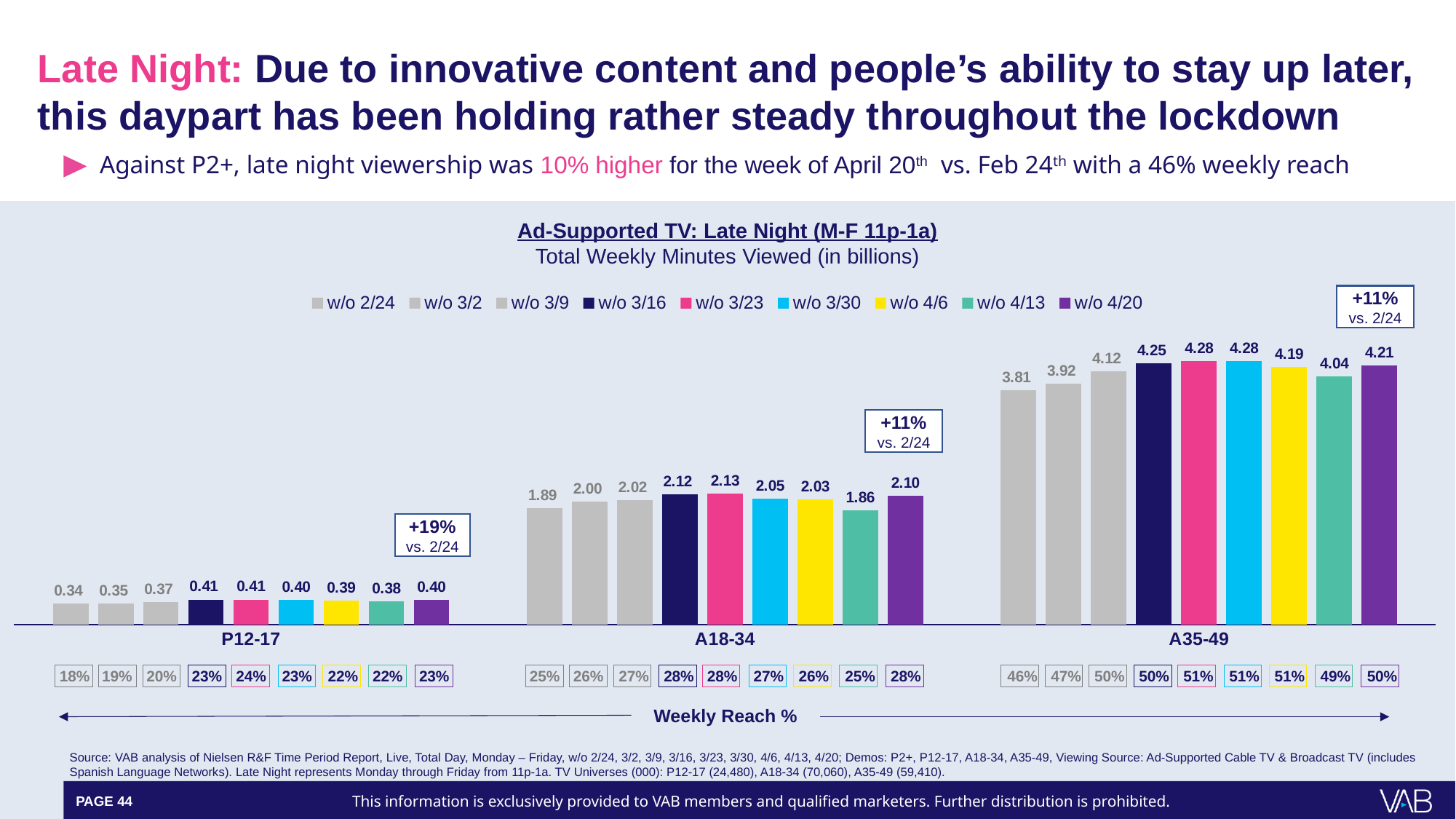
What is the total weekly minutes viewed (in billions) for A35-49 in the week of 4/20? 4.21 Which demographic group has the highest value for the week of 4/20? A35-49 What weekly reach % is shown for A35-49 in the week of 3/23? 51% For A35-49, which is larger: the value for w/o 4/6 or w/o 4/13? w/o 4/6 What is the value for P12-17 in the week of 2/24? 0.34 What kind of chart is shown on the slide? Bar chart What is the value for A18-34 in the week of 4/13? 1.86 What is the difference between the A18-34 values for w/o 4/20 and w/o 2/24? 0.21 What is the difference between the A35-49 values for w/o 4/20 and w/o 2/24? 0.40 How many demographic groups are shown on the x axis? 3 Which week has the lowest value for A18-34? w/o 4/13 How many series does the legend list? 9